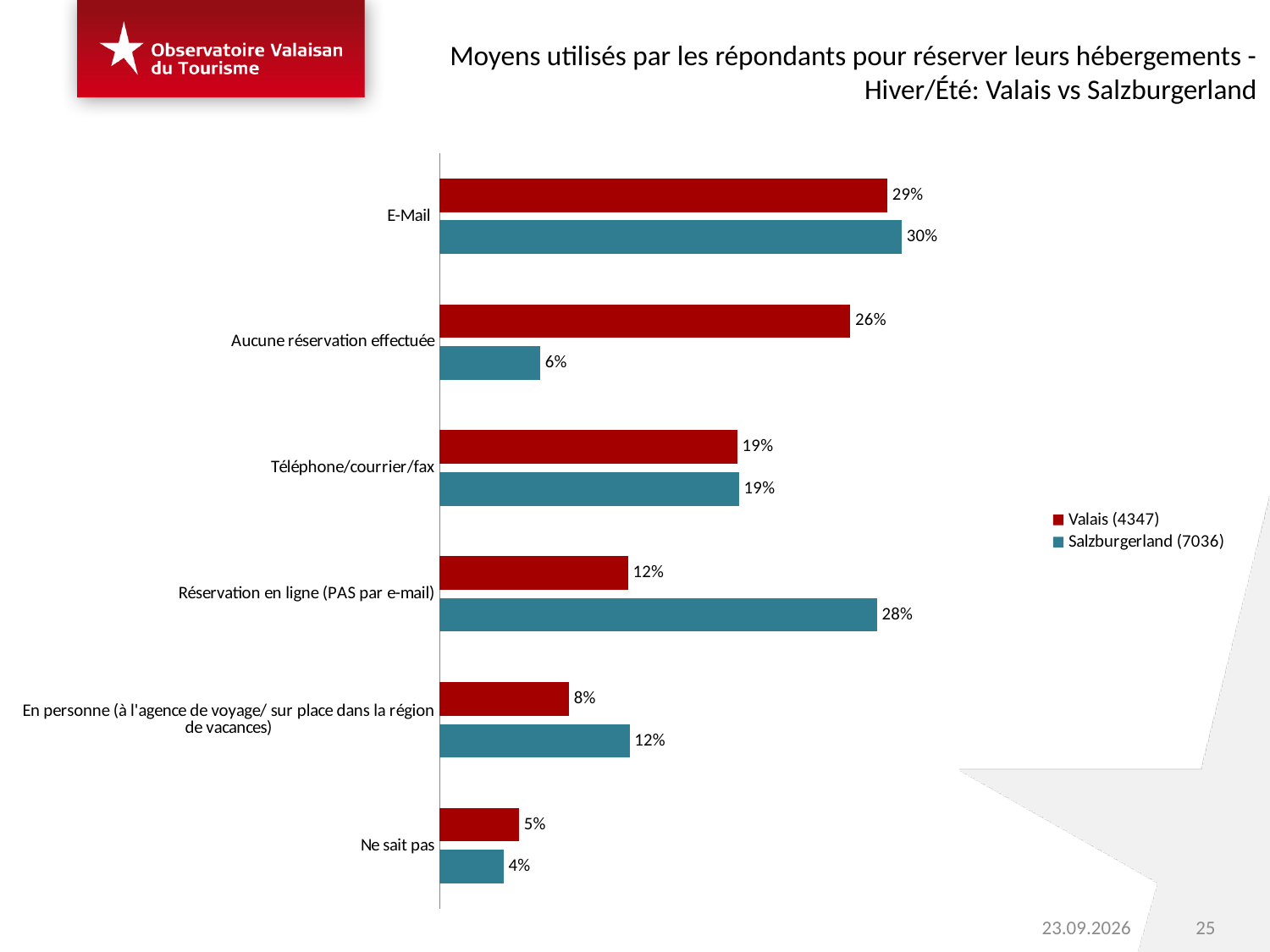
Which category has the lowest value for Valais (4347)? Ne sait pas What is the value for Salzburgerland (7036) for Aucune réservation effectuée? 6% Which category has the highest value for Salzburgerland (7036)? E-Mail How many series does the legend list? 2 What is the difference between the Salzburgerland (7036) and Valais (4347) values for Réservation en ligne (PAS par e-mail)? 16% What is the difference between the Valais (4347) and Salzburgerland (7036) values for Aucune réservation effectuée? 20% How many categories are shown on the chart? 6 What is the value for Valais (4347) for E-Mail? 29% For En personne (à l'agence de voyage/ sur place dans la région de vacances), which series has the larger value, Valais (4347) or Salzburgerland (7036)? Salzburgerland (7036) What is the value for Salzburgerland (7036) for Réservation en ligne (PAS par e-mail)? 28% What kind of chart is shown on the slide? Bar chart Which colour represents Valais (4347) in the chart? Red